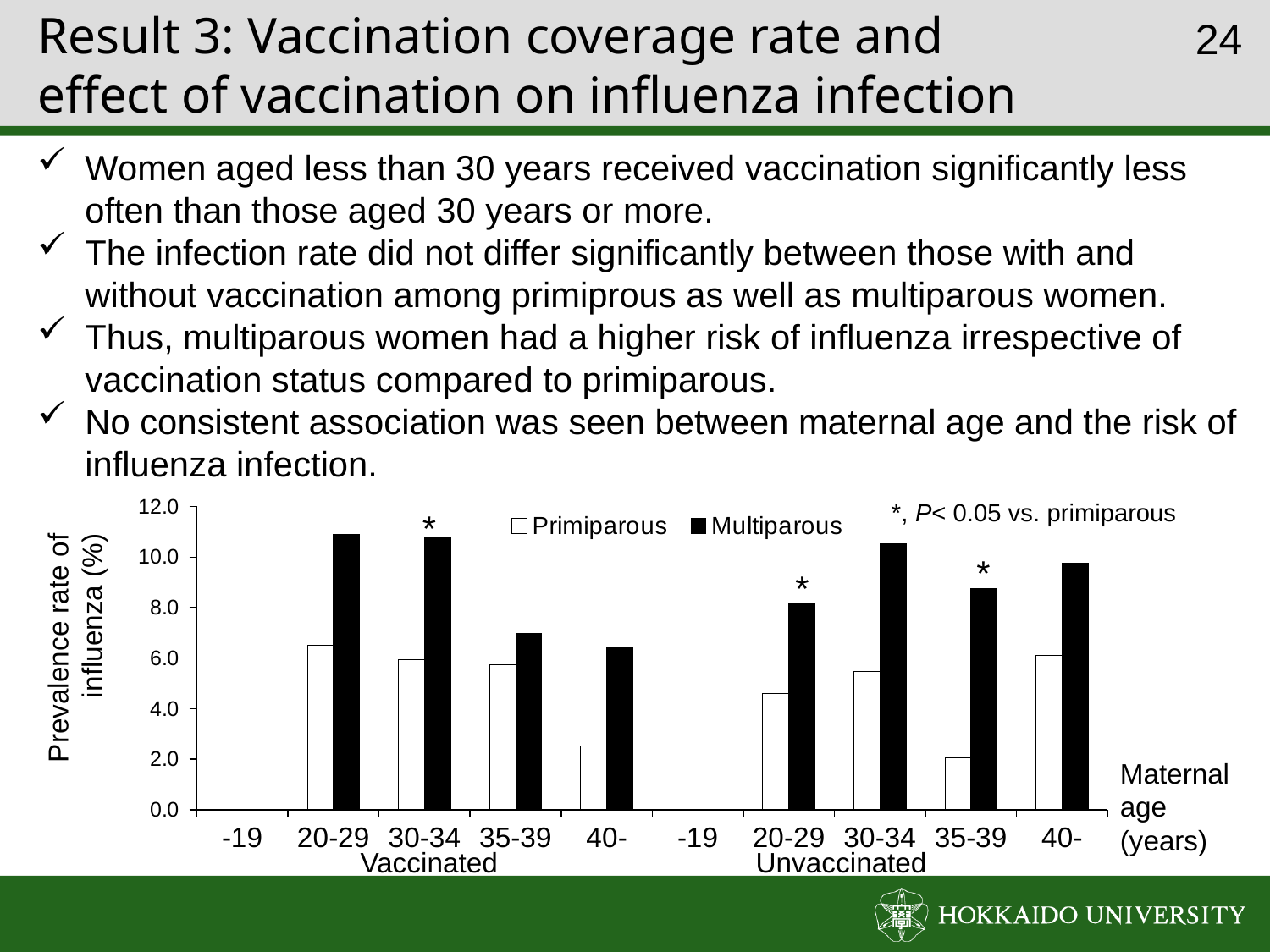
How many series does the legend list? 2 Is the Primiparous value for Unvaccinated women aged 35-39 greater or less than 4.0? less How many maternal age groups are shown on the x axis within the Vaccinated group? 5 What is the label of the y axis? Prevalence rate of influenza (%) What are the two series named in the legend? Primiparous and Multiparous For Vaccinated women aged 20-29, which series has the larger value, Primiparous or Multiparous? Multiparous What kind of chart is shown on the slide? bar chart Is the Multiparous value for Vaccinated women aged 35-39 greater or less than 8.0? less Is the Primiparous value for Vaccinated women aged 40- greater or less than 4.0? less Among Vaccinated women, is the Primiparous value larger for the 20-29 group or the 40- group? 20-29 For Unvaccinated women aged 35-39, which series has the larger value, Primiparous or Multiparous? Multiparous